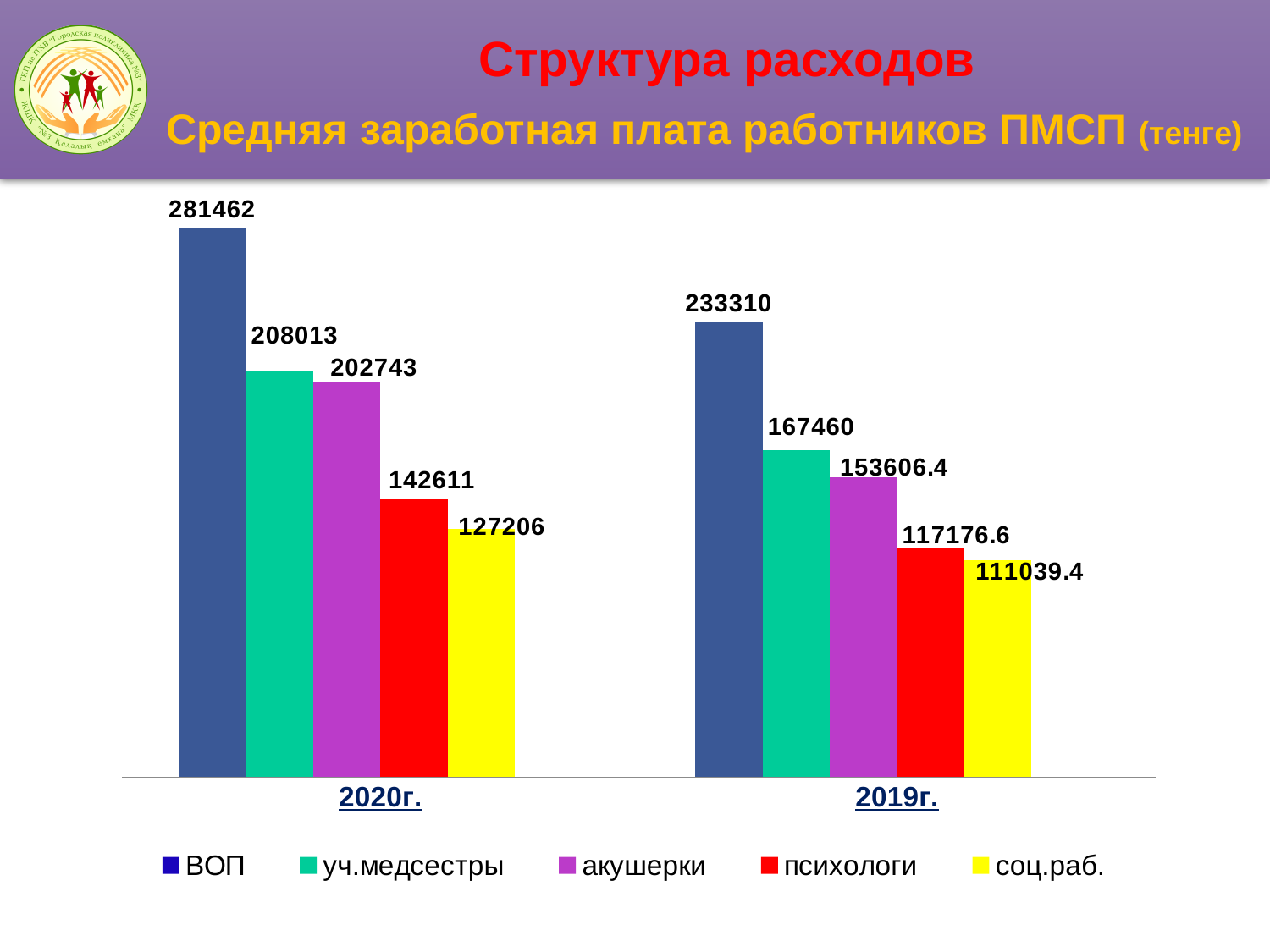
Which is larger: уч.медсестры in 2020г. or ВОП in 2019г.? ВОП in 2019г. What is the difference between the уч.медсестры and акушерки values in 2020г.? 5270 What is the value for соц.раб. in 2020г.? 127206 What kind of chart is shown on the slide? Bar chart What is the value for психологи in 2019г.? 117176.6 What is the difference between the ВОП values for 2020г. and 2019г.? 48152 How many year categories are shown on the x axis? 2 What is the value for акушерки in 2019г.? 153606.4 Which series has the highest value in 2019г.? ВОП Which series has the lowest value in 2020г.? соц.раб. How many series does the legend list? 5 What is the value for ВОП in 2020г.? 281462